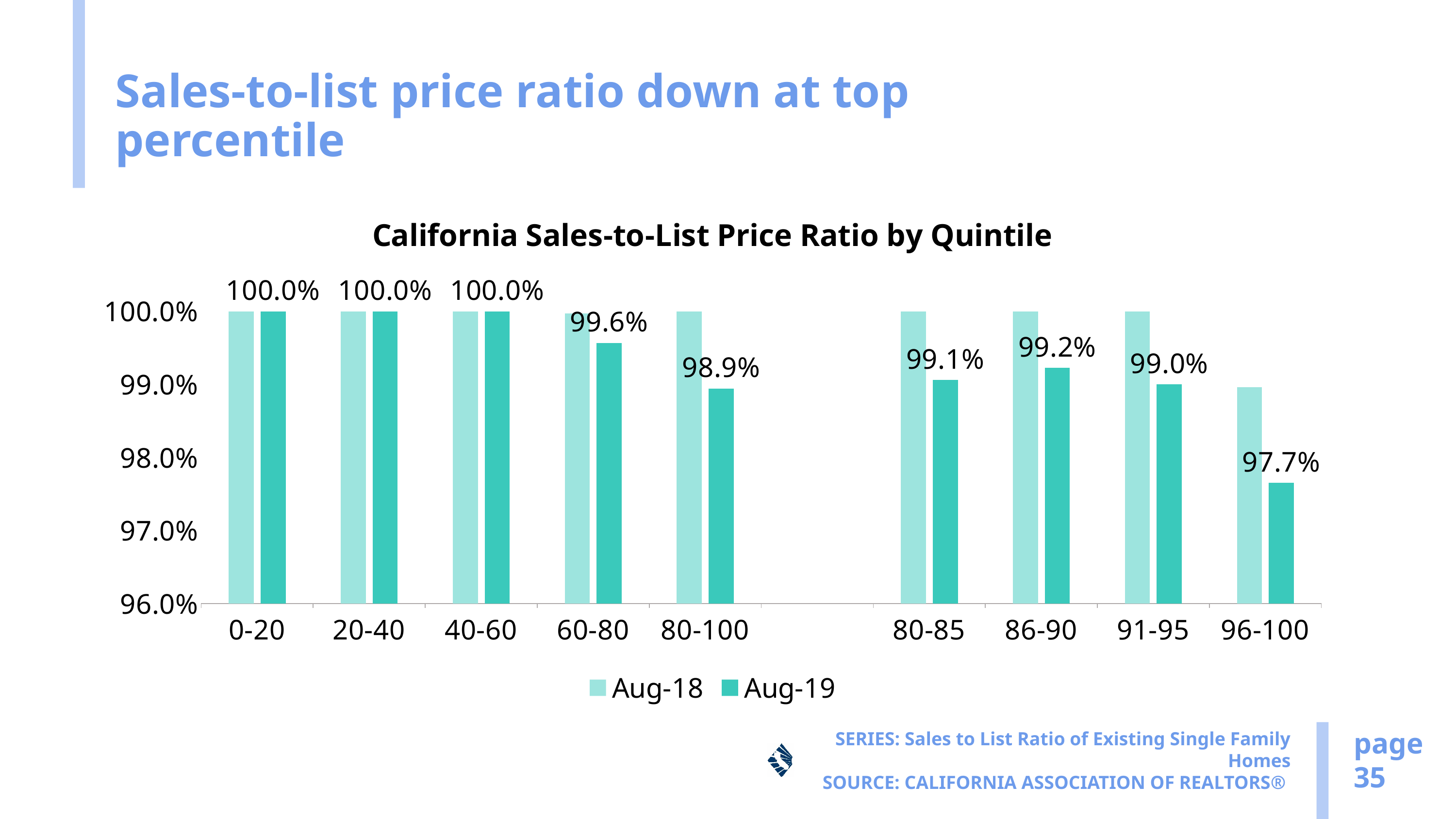
Is the Aug-18 value for 96-100 greater or less than 100.0%? less What is the difference between the Aug-19 values for 86-90 and 96-100? 1.5 percentage points How many categories are shown on the x axis? 9 What is the Aug-19 sales-to-list price ratio for the 96-100 quintile? 97.7% What is the Aug-19 value for the 60-80 category? 99.6% Which category has the lowest Aug-19 value? 96-100 What is the Aug-18 value for the 0-20 category? 100.0% What is the Aug-19 value for the 80-100 category? 98.9% Which has the larger Aug-19 value, 86-90 or 91-95? 86-90 What kind of chart is shown on the slide? bar chart Do the Aug-19 values rise or fall from 40-60 to 80-100? fall How many series does the legend list? 2